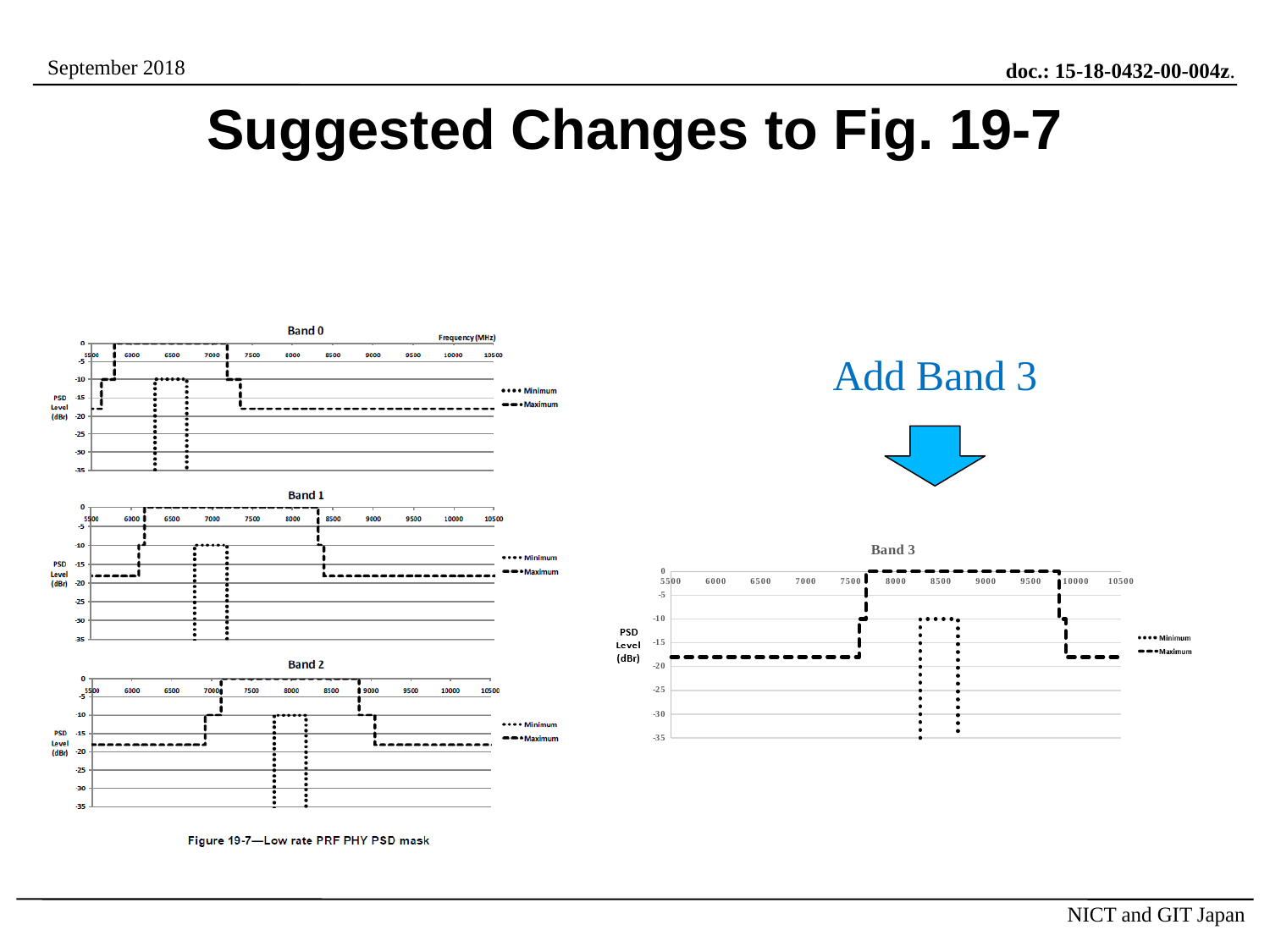
In the Band 3 chart, is the Maximum PSD level at 6000 MHz greater or less than -15? less In the Band 3 chart, does the Maximum line rise or fall between 7500 MHz and 8000 MHz? rise What are the two legend entries in the Band 3 chart? Minimum and Maximum In the Band 1 chart, is the Maximum PSD level at 9000 MHz greater or less than -15? less How many series does the legend of the Band 3 chart list? 2 In the Band 3 chart, what is the Minimum PSD level at 8500 MHz? -10 What kind of chart is the Band 3 chart on the right of the slide? line chart In the Band 3 chart, what is the Maximum PSD level at 8500 MHz? 0 How many band charts are shown on the slide in total? 4 In the Band 0 chart, what is the Maximum PSD level at 6500 MHz? 0 In the Band 2 chart, what is the Minimum PSD level at 8000 MHz? -10